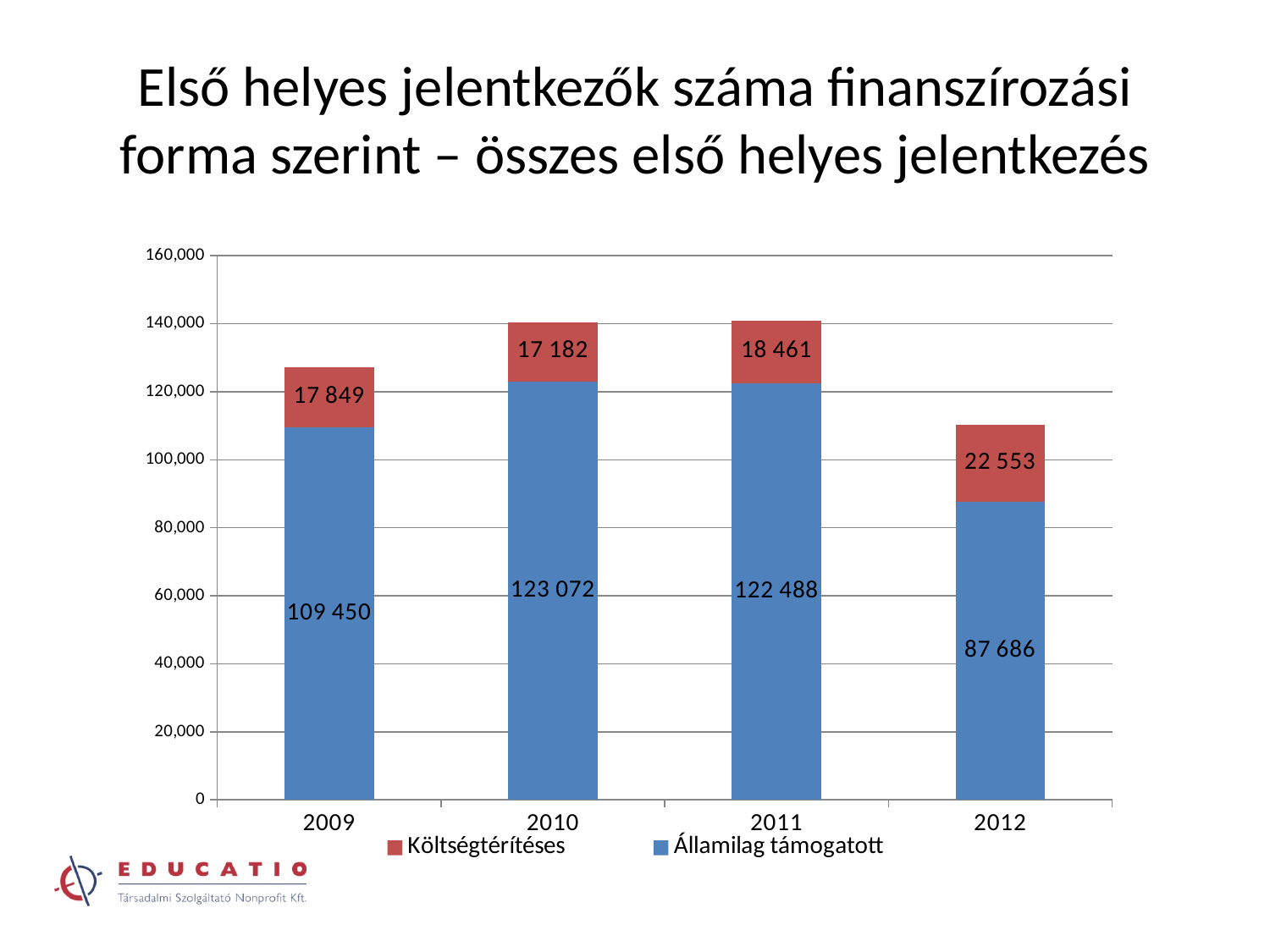
What is the value for Költségtérítéses in 2010? 17 182 Which year has the highest value for Költségtérítéses? 2012 What is the value for Államilag támogatott in 2009? 109 450 Is the Költségtérítéses value for 2011 larger or smaller than the Költségtérítéses value for 2010? larger What kind of chart is shown on the slide? stacked bar chart What is the difference between the Államilag támogatott values for 2009 and 2012? 21 764 How many series does the legend list? 2 What is the total of the stacked bar for 2011? 140 949 How many years are shown on the x axis? 4 What is the value for Költségtérítéses in 2012? 22 553 Which year has the highest value for Államilag támogatott? 2010 Which year has the lowest value for Államilag támogatott? 2012